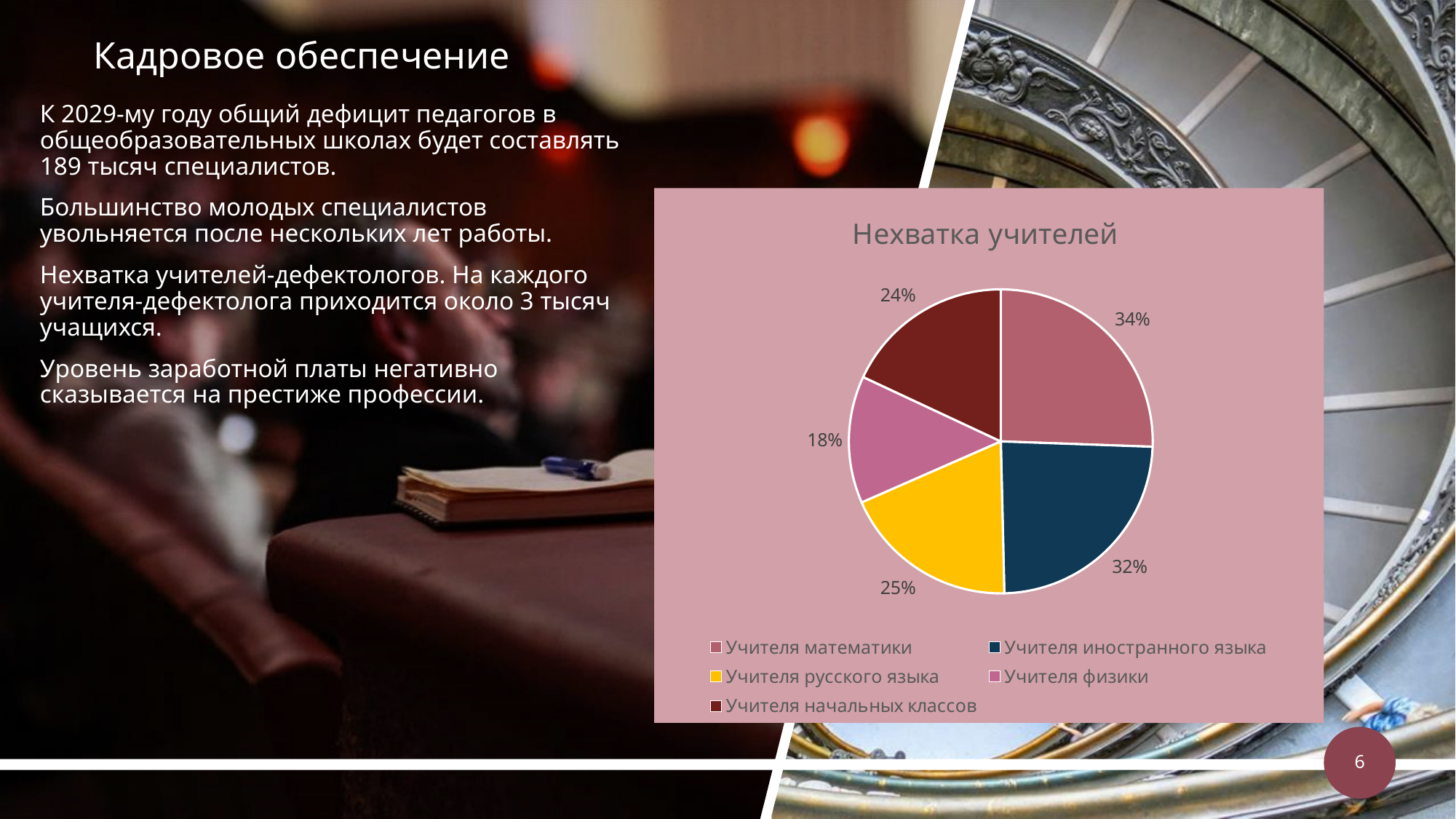
How many categories does the pie chart have? 5 Which is larger: the value for Учителя начальных классов or Учителя русского языка? Учителя русского языка What is the title of the chart? Нехватка учителей What value is shown for Учителя математики? 34% Which category has the highest value in the chart? Учителя математики What value is shown for Учителя физики? 18% What value is shown for Учителя начальных классов? 24% What kind of chart is shown on the slide? Pie chart What is the difference between the values for Учителя русского языка and Учителя физики? 7% What value is shown for Учителя иностранного языка? 32% Which category has the lowest value in the chart? Учителя физики What value is shown for Учителя русского языка? 25%